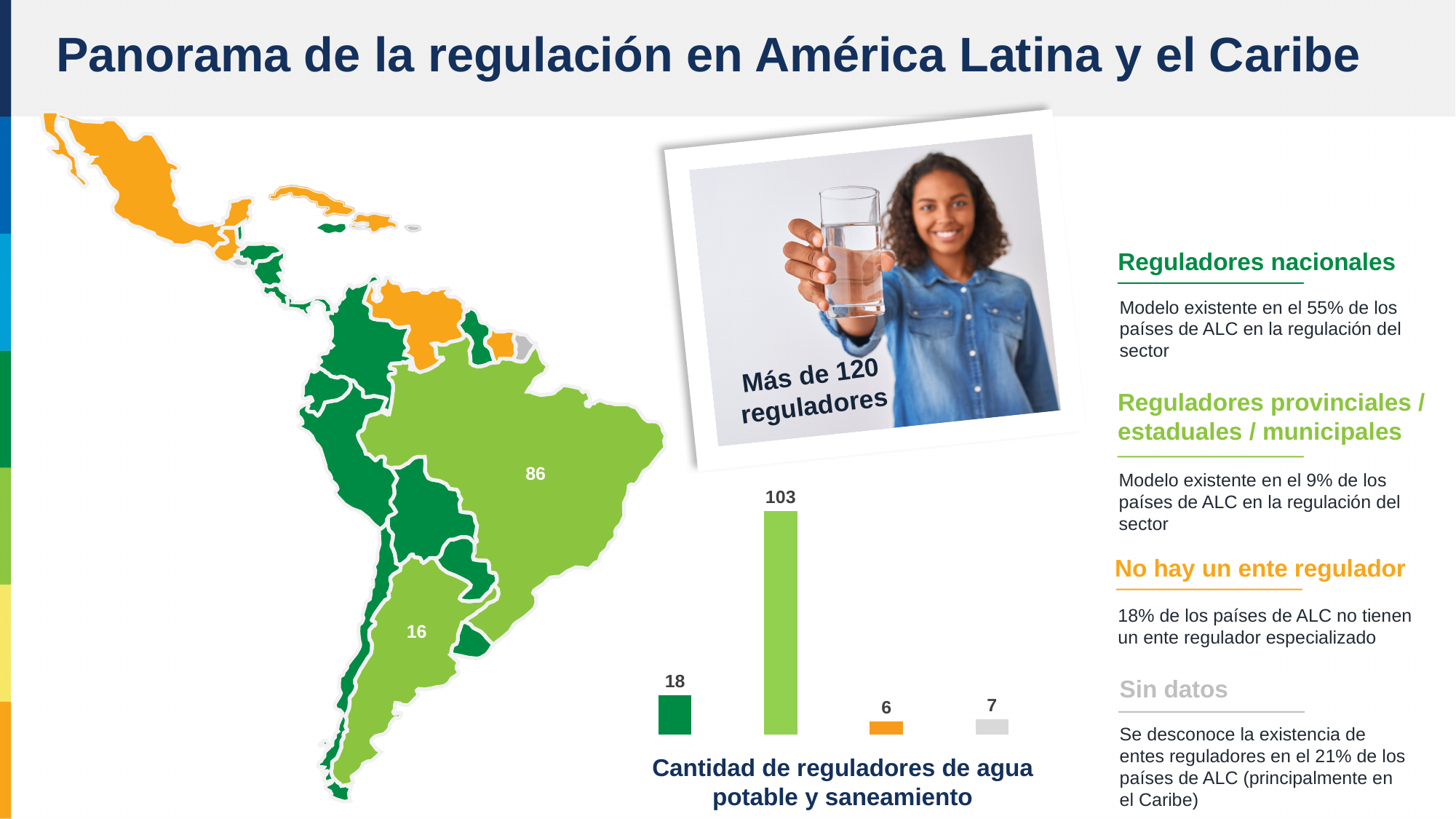
In the chart 'Cantidad de reguladores de agua potable y saneamiento', what is the value of the shortest (orange) bar? 6 In the chart 'Cantidad de reguladores de agua potable y saneamiento', which is larger: the orange bar or the gray bar? the gray bar (7) In the chart 'Cantidad de reguladores de agua potable y saneamiento', what is the difference between the gray bar and the orange bar? 1 How many bars does the chart 'Cantidad de reguladores de agua potable y saneamiento' have? 4 In the chart 'Cantidad de reguladores de agua potable y saneamiento', what is the difference between the light green bar (103) and the dark green bar (18)? 85 In the chart 'Cantidad de reguladores de agua potable y saneamiento', what is the value of the first (dark green) bar? 18 What is the title of the bar chart at the bottom of the slide? Cantidad de reguladores de agua potable y saneamiento In the chart 'Cantidad de reguladores de agua potable y saneamiento', what is the value of the tallest (light green) bar? 103 In the chart 'Cantidad de reguladores de agua potable y saneamiento', what colour is the bar with value 103? light green In the chart 'Cantidad de reguladores de agua potable y saneamiento', what is the total of all four bars? 134 In the chart 'Cantidad de reguladores de agua potable y saneamiento', what is the value of the last (gray) bar? 7 What kind of chart is shown under the title 'Cantidad de reguladores de agua potable y saneamiento'? bar chart